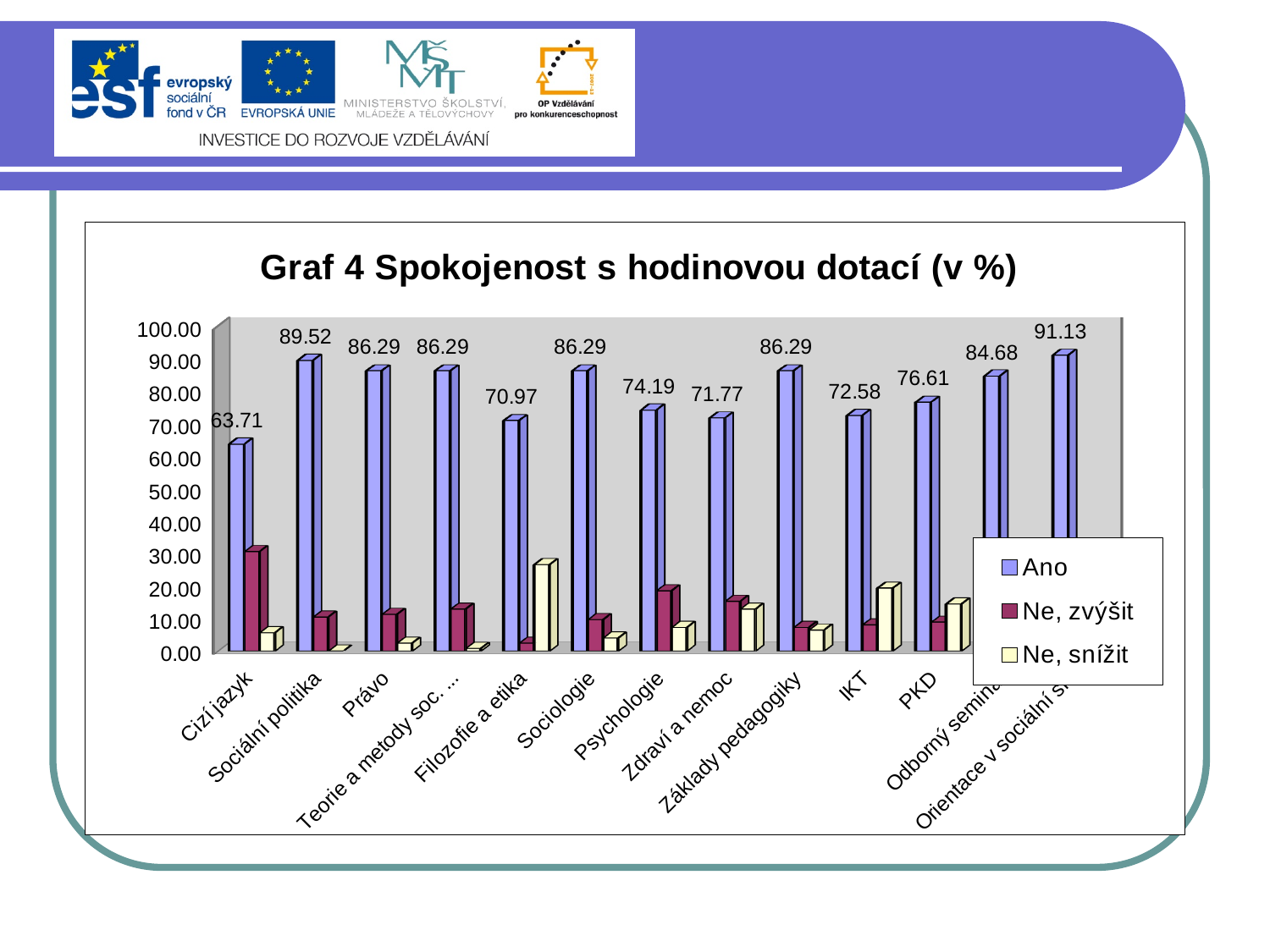
Which has the larger Ano value, Psychologie or Zdraví a nemoc? Psychologie What is the difference between the Ano values for PKD and IKT? 4.03 What is the Ano value for Sociální politika? 89.52 Is the Ne, snížit value for Sociální politika greater or less than 10.00? less What kind of chart is shown on the slide? Bar chart Which category has the lowest Ano value? Cizí jazyk What is the difference between the Ano values for Sociální politika and Cizí jazyk? 25.81 What is the Ano value for Cizí jazyk? 63.71 What is the Ano value for PKD? 76.61 What is the Ano value for Filozofie a etika? 70.97 Is the Ne, zvýšit value for Cizí jazyk greater or less than 20.00? greater How many series does the legend list? 3